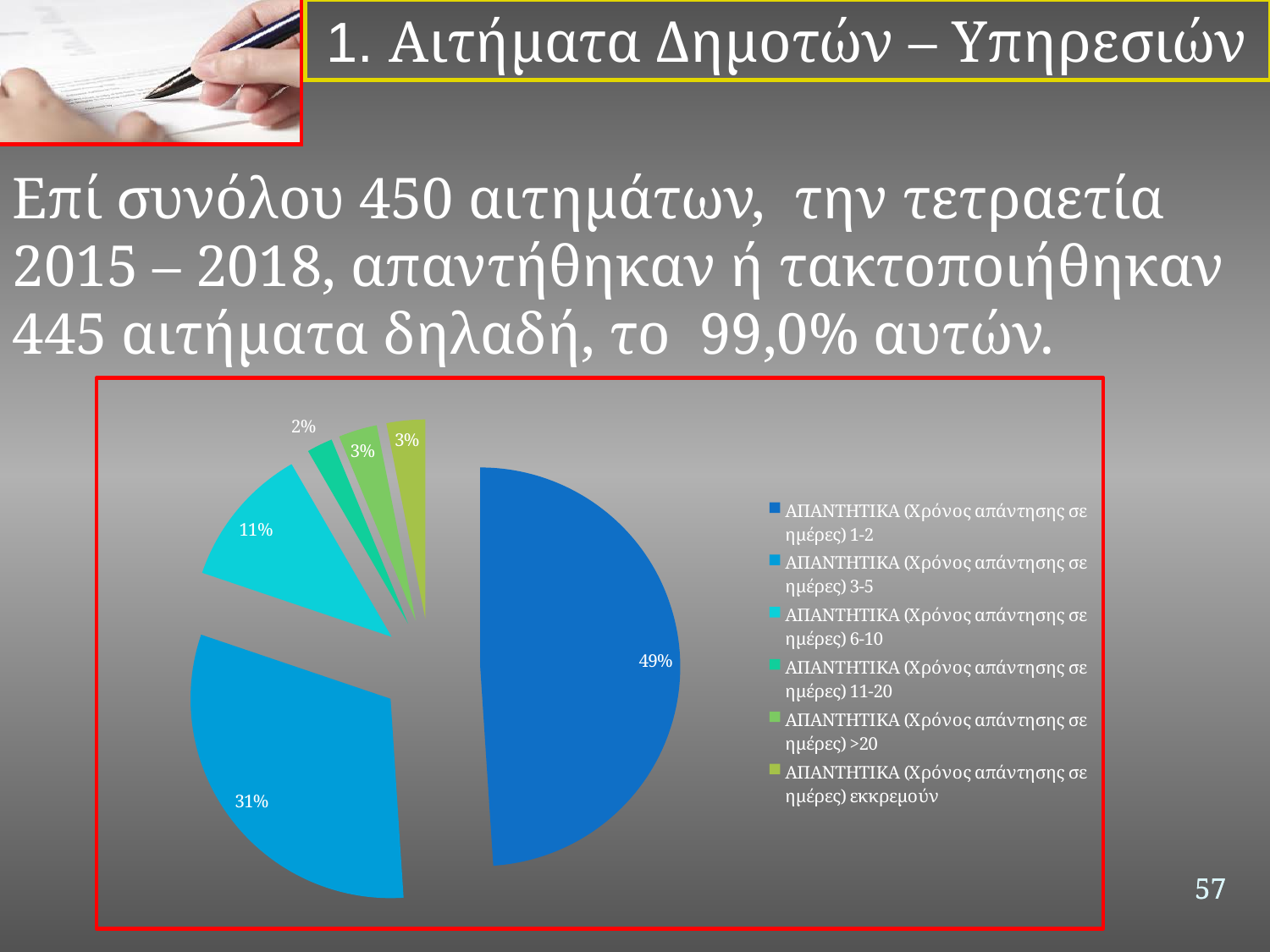
What share of the pie is labelled for ΑΠΑΝΤΗΤΙΚΑ (Χρόνος απάντησης σε ημέρες) 3-5? 31% Which slice is larger: 3-5 days or 6-10 days? 3-5 days How many slices does the pie chart have? 6 What share of the pie is labelled for ΑΠΑΝΤΗΤΙΚΑ (Χρόνος απάντησης σε ημέρες) 1-2? 49% How many entries does the legend list? 6 Which category has the largest slice of the pie? ΑΠΑΝΤΗΤΙΚΑ (Χρόνος απάντησης σε ημέρες) 1-2 What share of the pie is labelled for ΑΠΑΝΤΗΤΙΚΑ (Χρόνος απάντησης σε ημέρες) 6-10? 11% What share of the pie is labelled for ΑΠΑΝΤΗΤΙΚΑ (Χρόνος απάντησης σε ημέρες) 11-20? 2% Which category has the smallest slice of the pie? ΑΠΑΝΤΗΤΙΚΑ (Χρόνος απάντησης σε ημέρες) 11-20 What is the difference in percentage points between the 1-2 days slice and the 3-5 days slice? 18 What colour is the slice for ΑΠΑΝΤΗΤΙΚΑ (Χρόνος απάντησης σε ημέρες) 1-2? dark blue What kind of chart is shown on the slide? pie chart